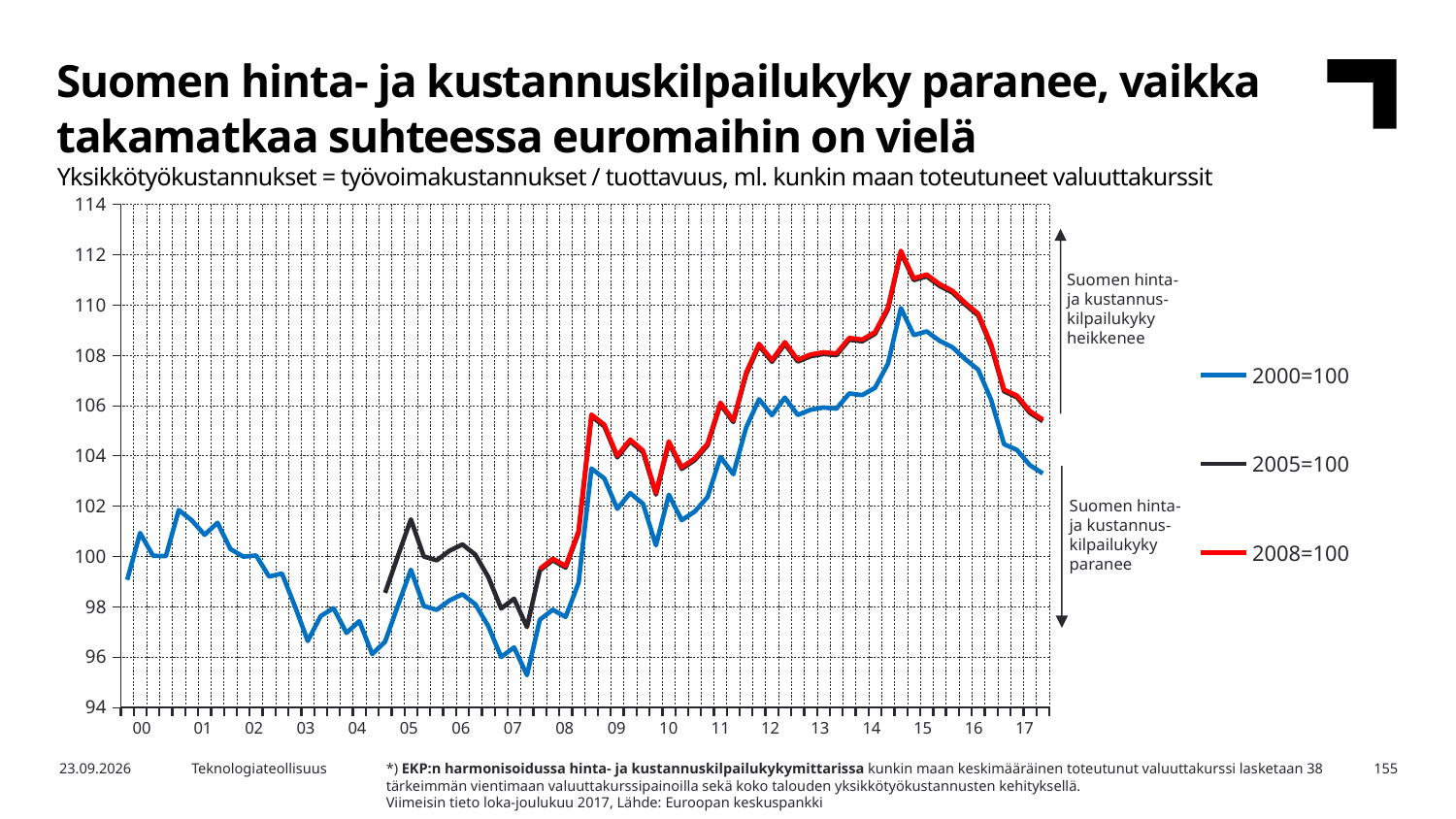
How many series does the legend list? 3 Does the 2000=100 series rise or fall between 2015 and 2017? fall How many year labels are shown along the x axis? 18 Is the final value of the 2000=100 series at the end of 2017 greater or less than 104? less What kind of chart is shown on the slide? line chart Which series reaches the highest value on the chart? 2008=100 Is the peak value of the 2000=100 series around 2015 greater or less than 108? greater What colour is the line for the 2008=100 series? red What are the three series named in the legend? 2000=100, 2005=100, 2008=100 Is the lowest value of the 2000=100 series, reached around 2007, greater or less than 96? less At the end of 2017, which series has the higher value, 2000=100 or 2008=100? 2008=100